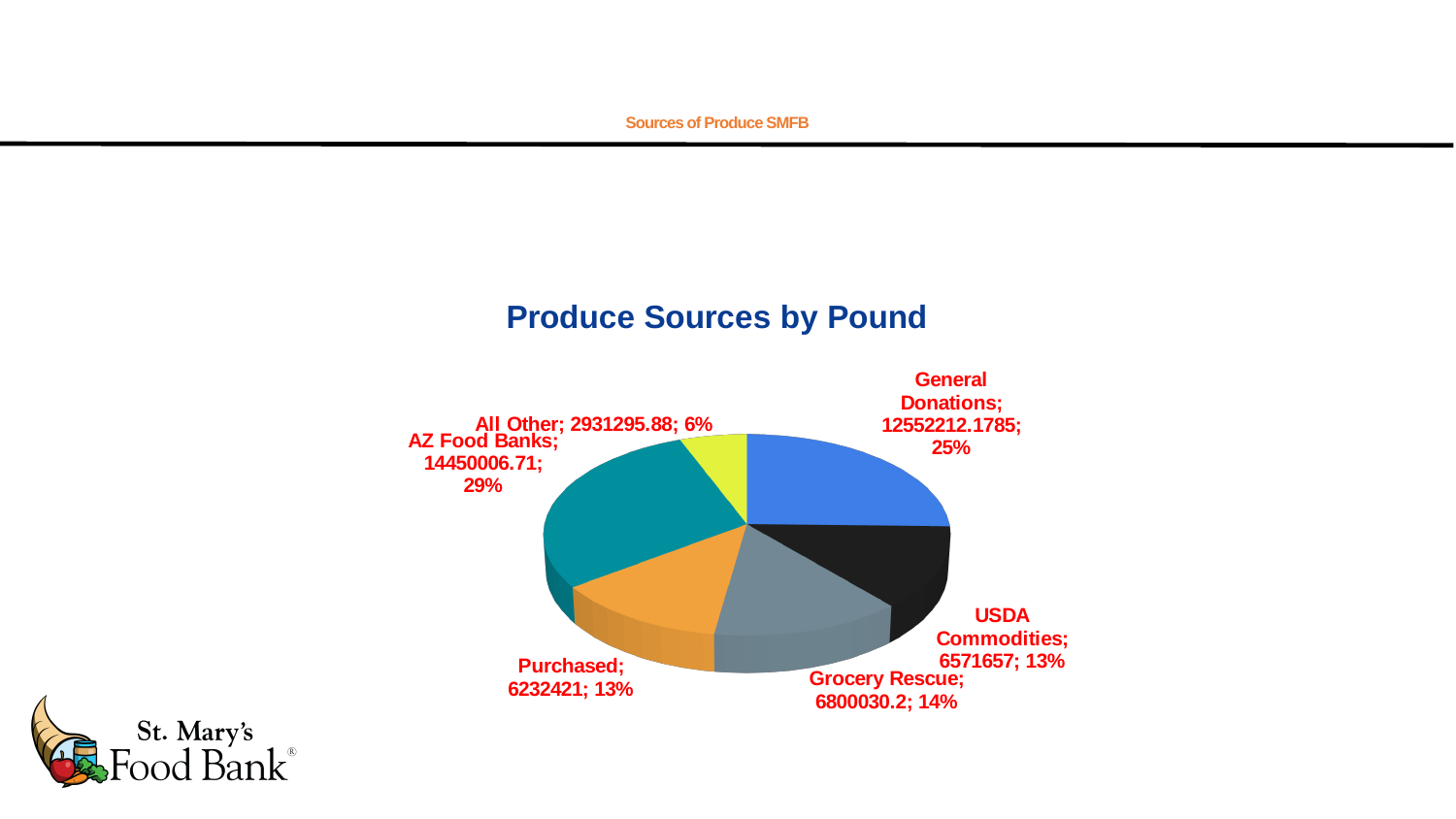
What is the value shown for AZ Food Banks? 14450006.71 Which source has the largest share of the pie? AZ Food Banks What type of chart is shown on the slide? Pie chart What is the value shown for General Donations? 12552212.1785 What is the difference between the value for USDA Commodities and the value for Purchased? 339236 What is the value shown for Grocery Rescue? 6800030.2 What percentage share does AZ Food Banks have? 29% Which is larger, the value for Grocery Rescue or the value for Purchased? Grocery Rescue How many slices does the pie chart have? 6 Which source has the smallest share of the pie? All Other What is the title of the chart? Produce Sources by Pound What percentage share does All Other have? 6%